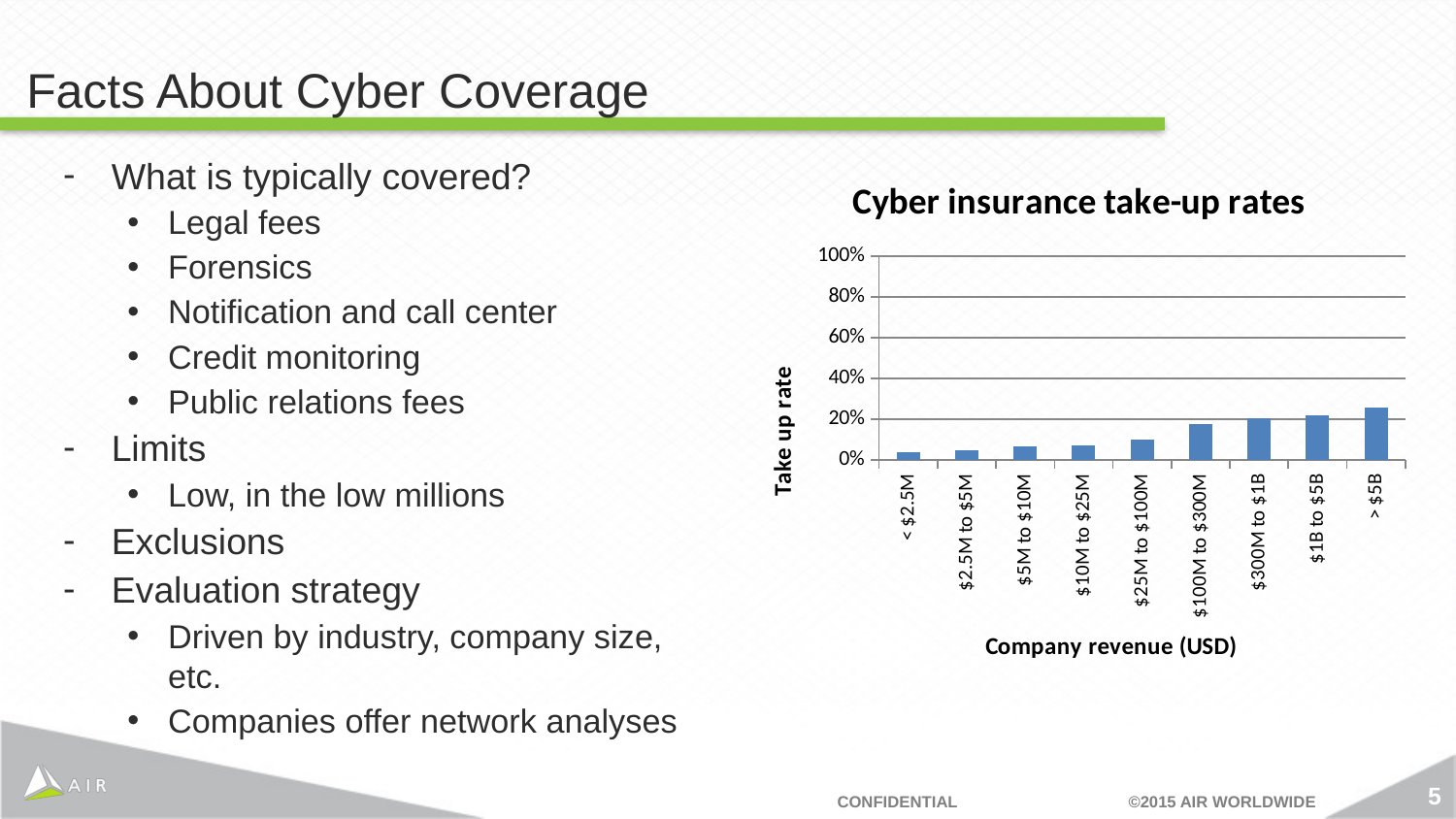
Do take-up rates rise or fall as company revenue increases along the x axis? rise Which company revenue category has the highest take-up rate? > $5B Is the take-up rate for < $2.5M greater or less than 20%? less What is the label of the x axis? Company revenue (USD) Which has a higher take-up rate, $25M to $100M or $300M to $1B? $300M to $1B Is the take-up rate for > $5B greater or less than 40%? less What type of chart is shown on the slide? bar chart Is the take-up rate for > $5B greater or less than 20%? greater What is the title of the chart? Cyber insurance take-up rates Which has a higher take-up rate, < $2.5M or > $5B? > $5B How many company revenue categories are shown in the chart? 9